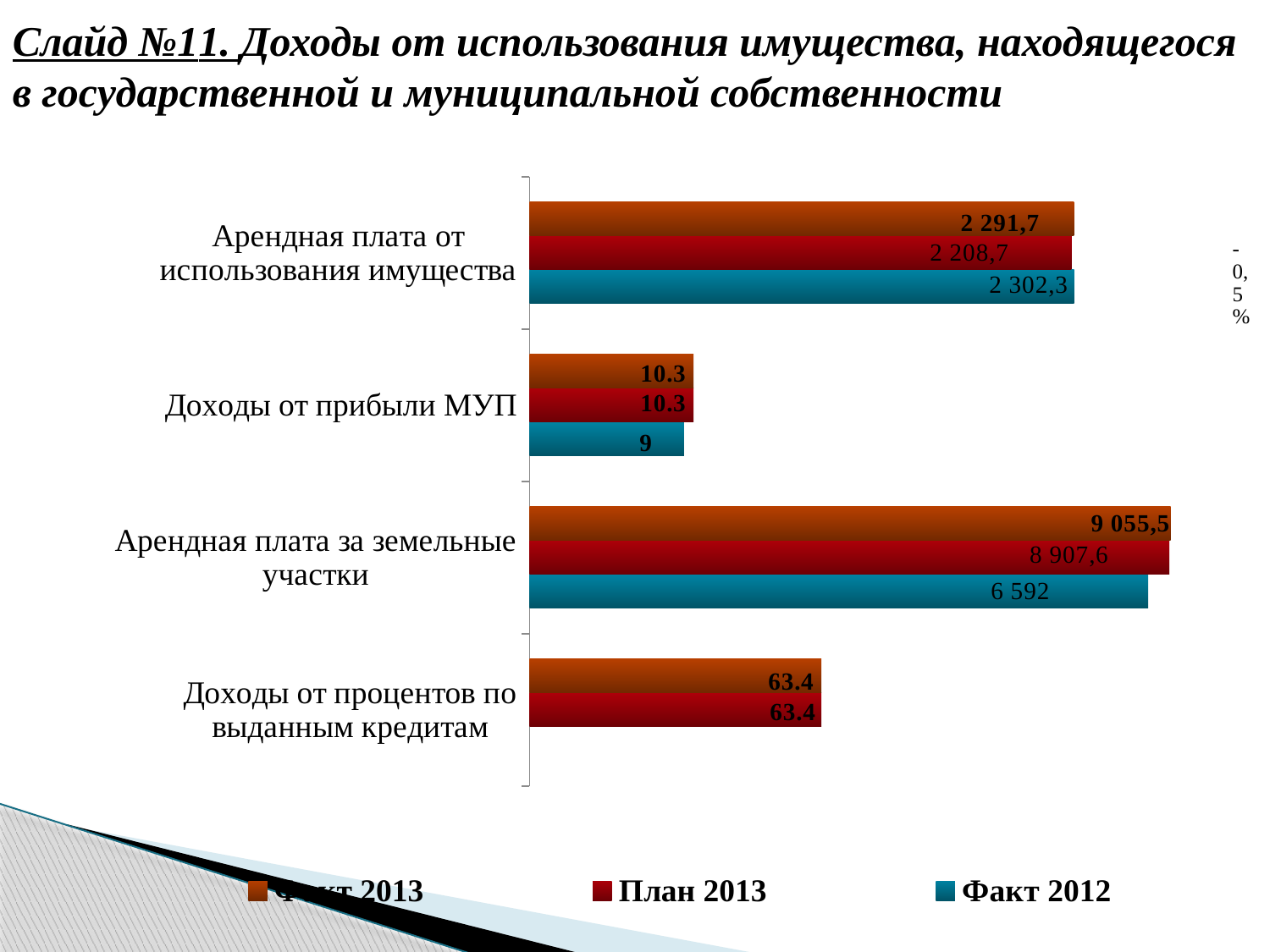
For Арендная плата от использования имущества, which is larger: the Факт 2012 value or the Факт 2013 value? Факт 2012 What is the Факт 2012 value for Арендная плата от использования имущества? 2 302,3 How many series does the legend list? 3 What kind of chart is shown on the slide? Bar chart What is the difference between the Факт 2013 and Факт 2012 values for Арендная плата за земельные участки? 2 463,5 How many categories are shown on the chart? 4 What is the Факт 2013 value for Арендная плата за земельные участки? 9 055,5 What is the Факт 2012 value for Доходы от прибыли МУП? 9 What is the План 2013 value for Доходы от прибыли МУП? 10.3 Which category has the lowest Факт 2013 value? Доходы от прибыли МУП What is the difference between the Факт 2013 and План 2013 values for Арендная плата за земельные участки? 147,9 Which category has the highest Факт 2012 value? Арендная плата за земельные участки